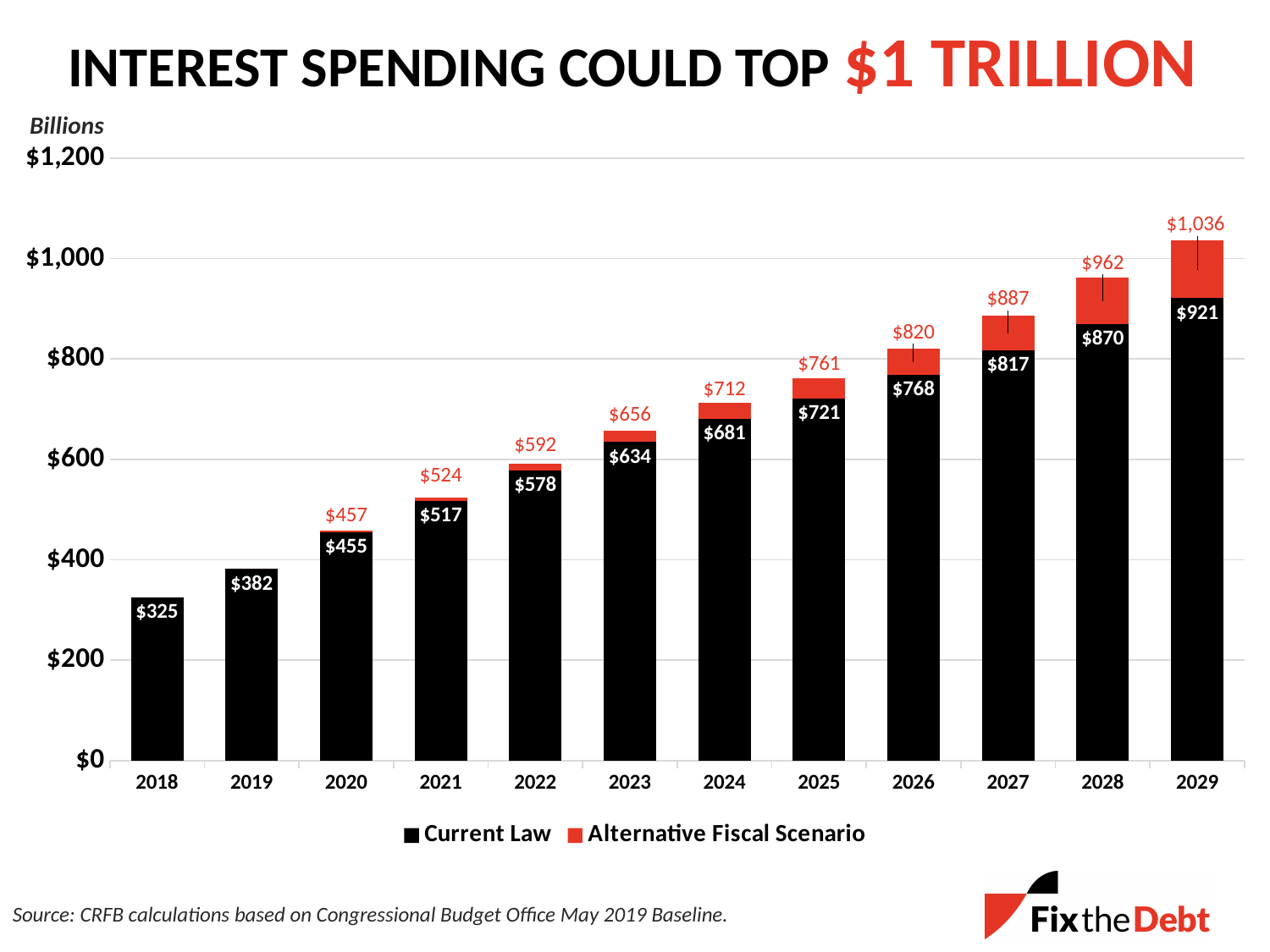
What is the difference between the Current Law values for 2019 and 2018? $57 What value is labelled in red above the 2029 bar? $1,036 Is the Current Law value for 2025 greater or less than $800? less Do the Current Law values rise or fall from 2018 to 2029? rise How many series does the legend list? 2 How many years are shown on the x axis? 12 What value is labelled in red above the 2024 bar? $712 What is the Current Law value for 2018? $325 Which year has the highest Current Law value? 2029 What is the Current Law value for 2029? $921 What is the difference between the red label for 2029 ($1,036) and the Current Law value for 2029 ($921)? $115 Which year has the lowest Current Law value? 2018